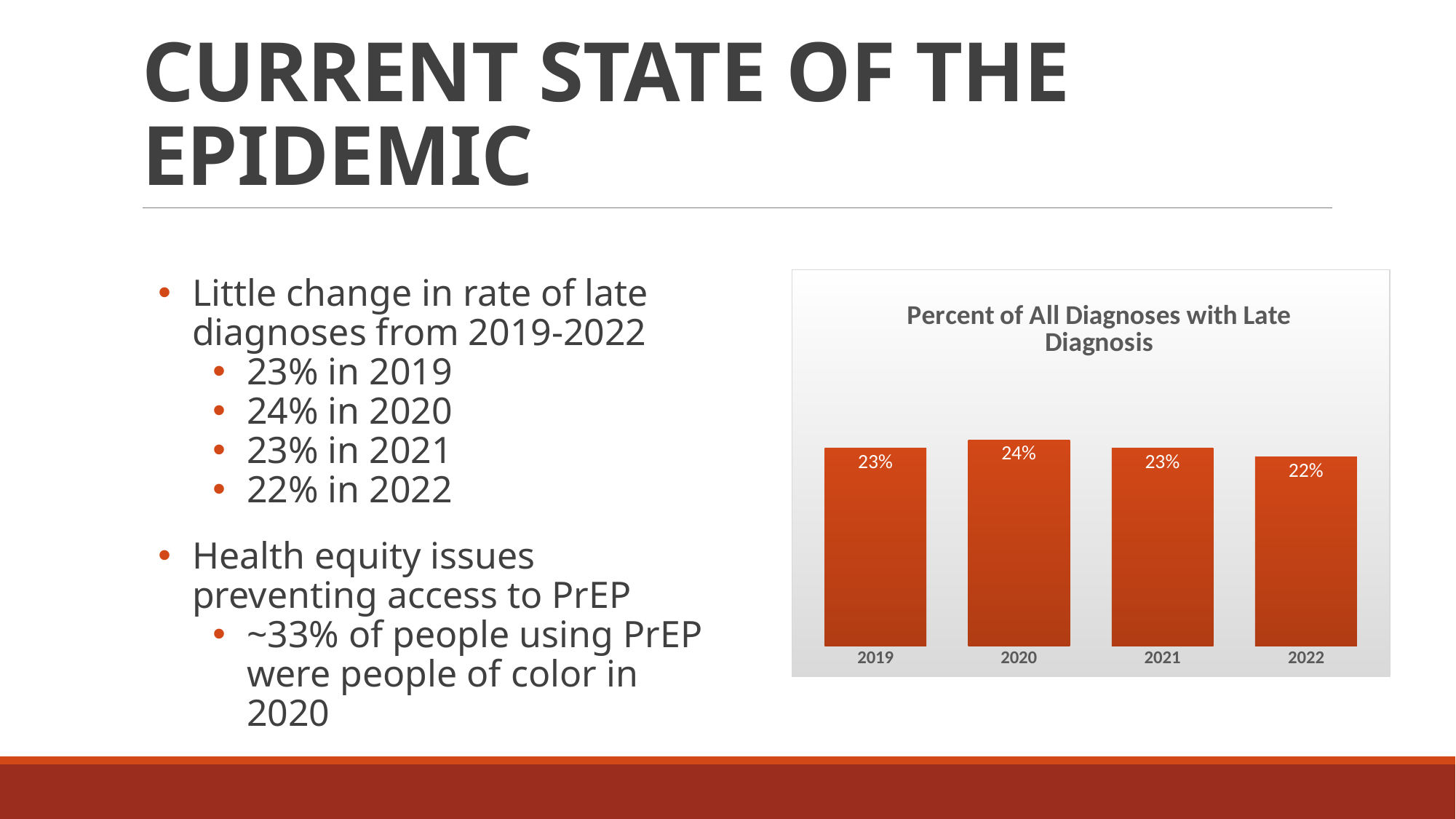
What colour are the bars in the chart? Orange-red Which year has a larger value, 2020 or 2021? 2020 What is the percent of all diagnoses with late diagnosis in 2020? 24% Which year has the highest percent of diagnoses with late diagnosis? 2020 Which year has the lowest percent of diagnoses with late diagnosis? 2022 How many years are shown on the chart? 4 What is the title of the chart? Percent of All Diagnoses with Late Diagnosis What is the percent of all diagnoses with late diagnosis in 2019? 23% What is the difference in percentage points between the 2020 and 2022 values? 2 What type of chart is shown on the slide? Bar chart Does the value rise or fall from 2020 to 2022? Fall What is the percent of all diagnoses with late diagnosis in 2022? 22%